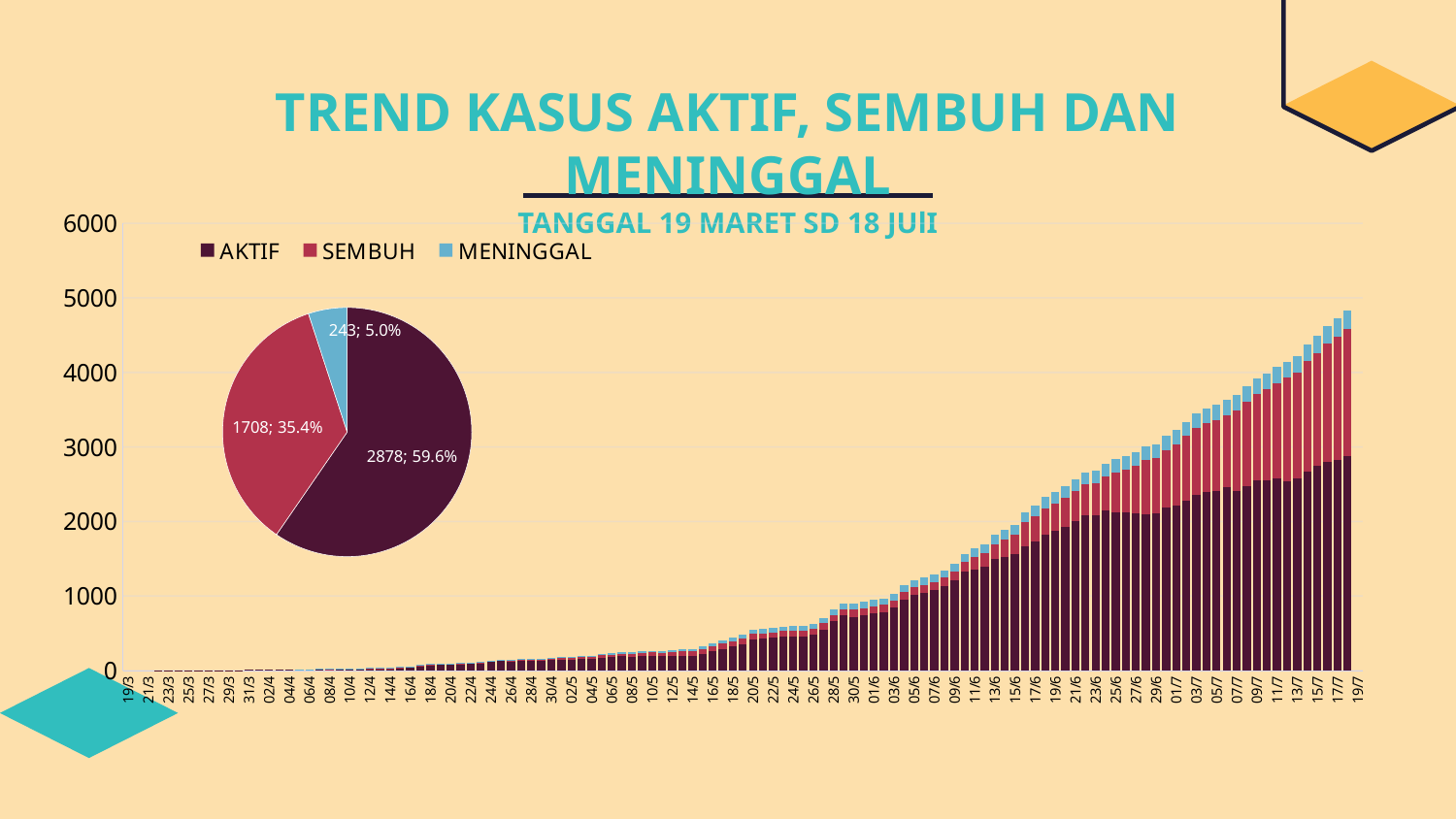
In the pie chart, what is the total of the three slice values? 4829 In the pie chart, which is larger, the SEMBUH value or the MENINGGAL value? SEMBUH In the bar chart, is the total stacked value for 19/7 greater or less than 4000? greater In the pie chart, which category has the largest slice? AKTIF In the pie chart, what share of the total does MENINGGAL represent? 5.0% In the pie chart, what is the difference between the AKTIF value and the SEMBUH value? 1170 In the pie chart, what value and percentage are shown for the AKTIF slice? 2878; 59.6% In the pie chart, what value is shown for the SEMBUH slice? 1708 In the pie chart, which category has the smallest slice? MENINGGAL What kind of chart is the large chart showing dates along the x axis? Stacked bar chart In the bar chart, do the stacked totals rise or fall from 19/3 to 19/7? Rise How many series does the legend of the bar chart list? 3